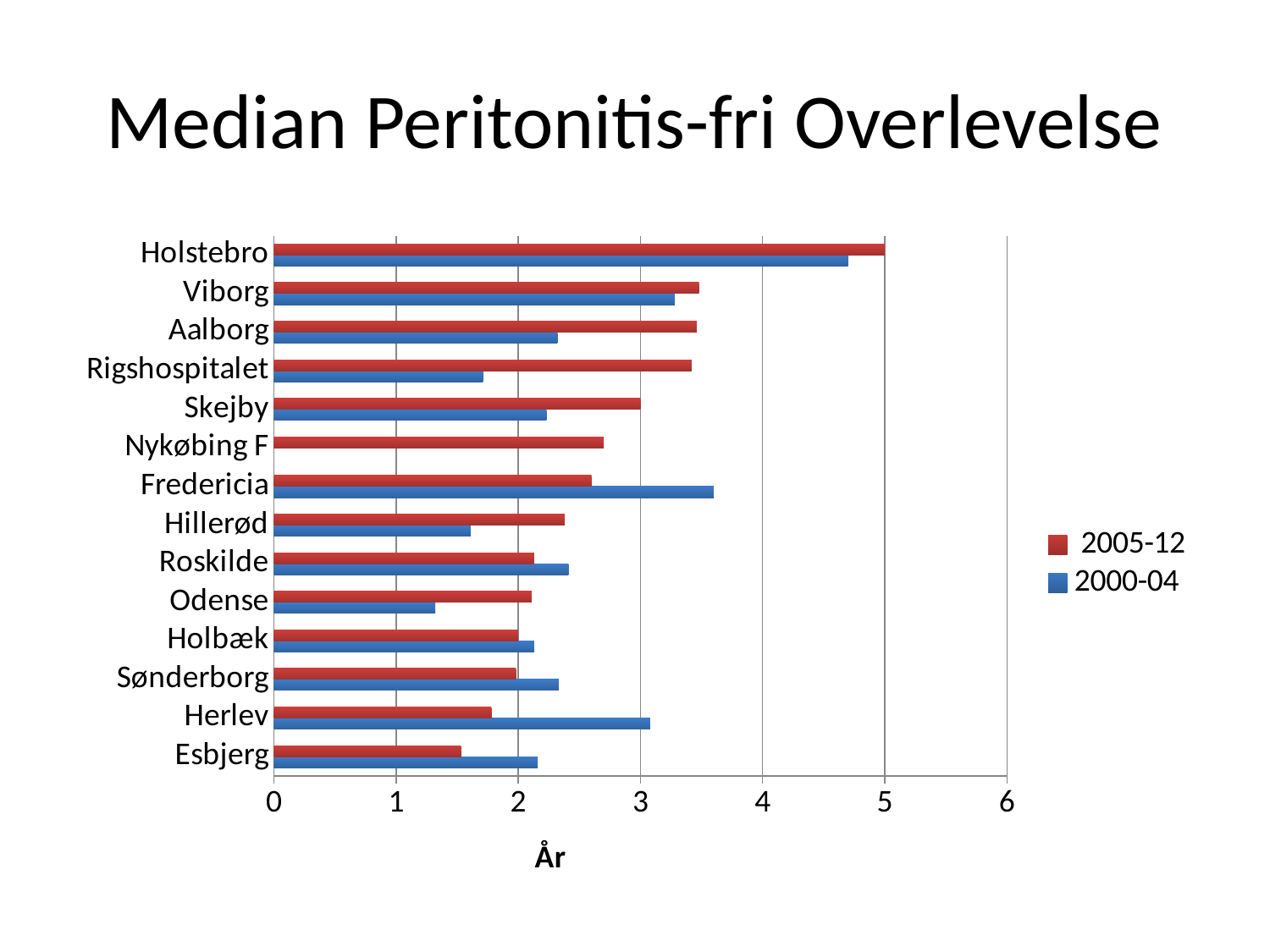
What is the title of the x axis? År How many hospitals (categories) are shown on the y axis? 14 Is the 2000-04 value for Rigshospitalet greater or less than 2? less How many series does the legend list? 2 For Aalborg, which series has the larger value, 2005-12 or 2000-04? 2005-12 For Herlev, which series has the larger value, 2005-12 or 2000-04? 2000-04 Which hospital has the highest value for the 2000-04 series? Holstebro Which hospital has the highest value for the 2005-12 series? Holstebro Which hospital has the lowest value for the 2005-12 series? Esbjerg What kind of chart is shown on the slide? bar chart Is the 2005-12 value for Viborg greater or less than 3? greater Is the 2000-04 value for Fredericia greater or less than 3? greater